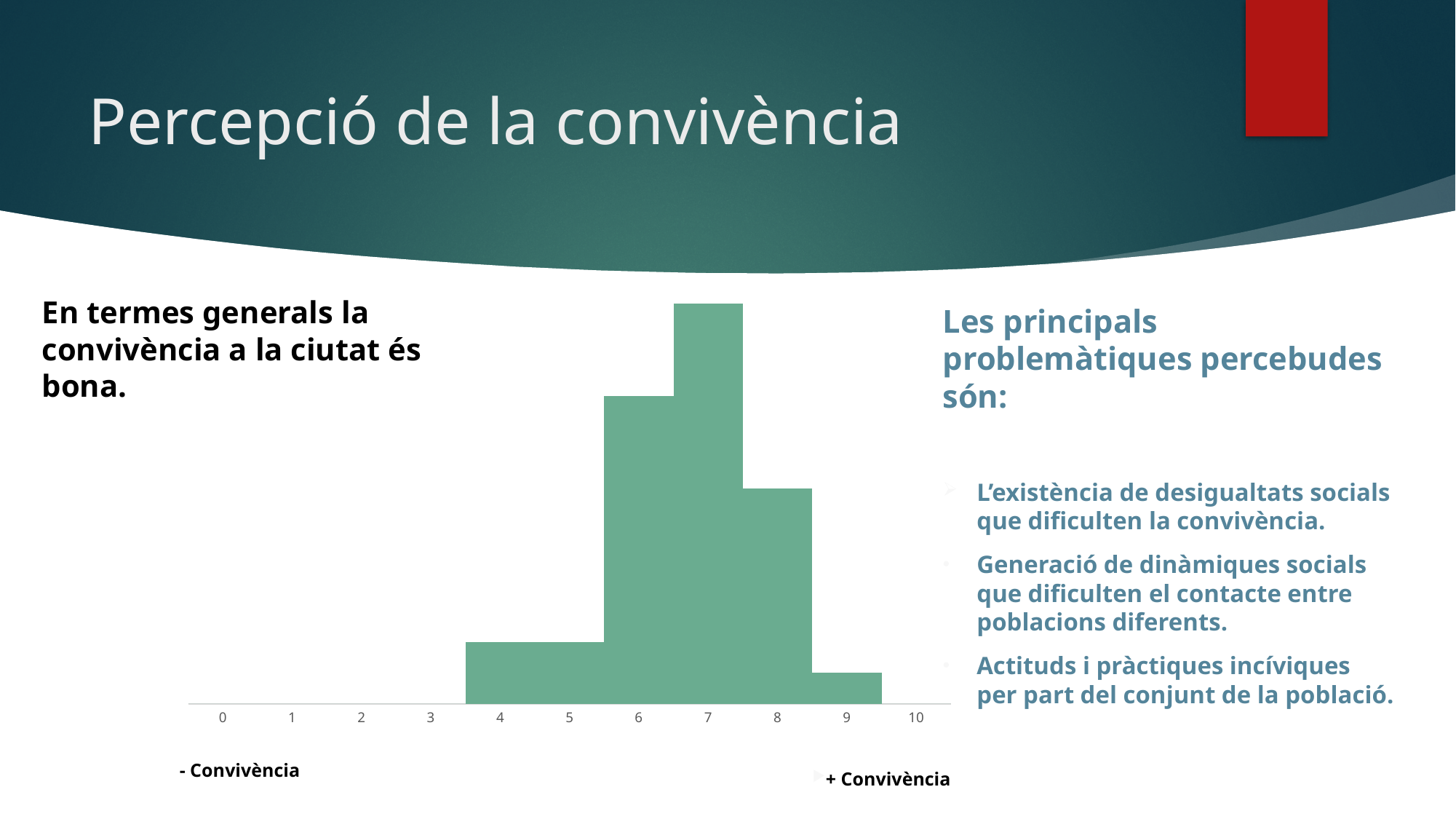
Which is larger, the value for 4 or the value for 9? 4 Which is larger, the value for 7 or the value for 8? 7 How many categories on the x axis have a visible bar? 6 Among the categories with a visible bar, which one has the lowest value? 9 Do the values rise or fall along the x axis from 7 to 9? fall Which is larger, the value for 8 or the value for 9? 8 What kind of chart is shown on the slide? bar chart How many categories are labelled on the x axis of the chart? 11 Do the values rise or fall along the x axis from 4 to 7? rise (4 and 5 are equal, then rise) Which category on the x axis has the highest bar? 7 What label appears below the right end of the x axis? + Convivència